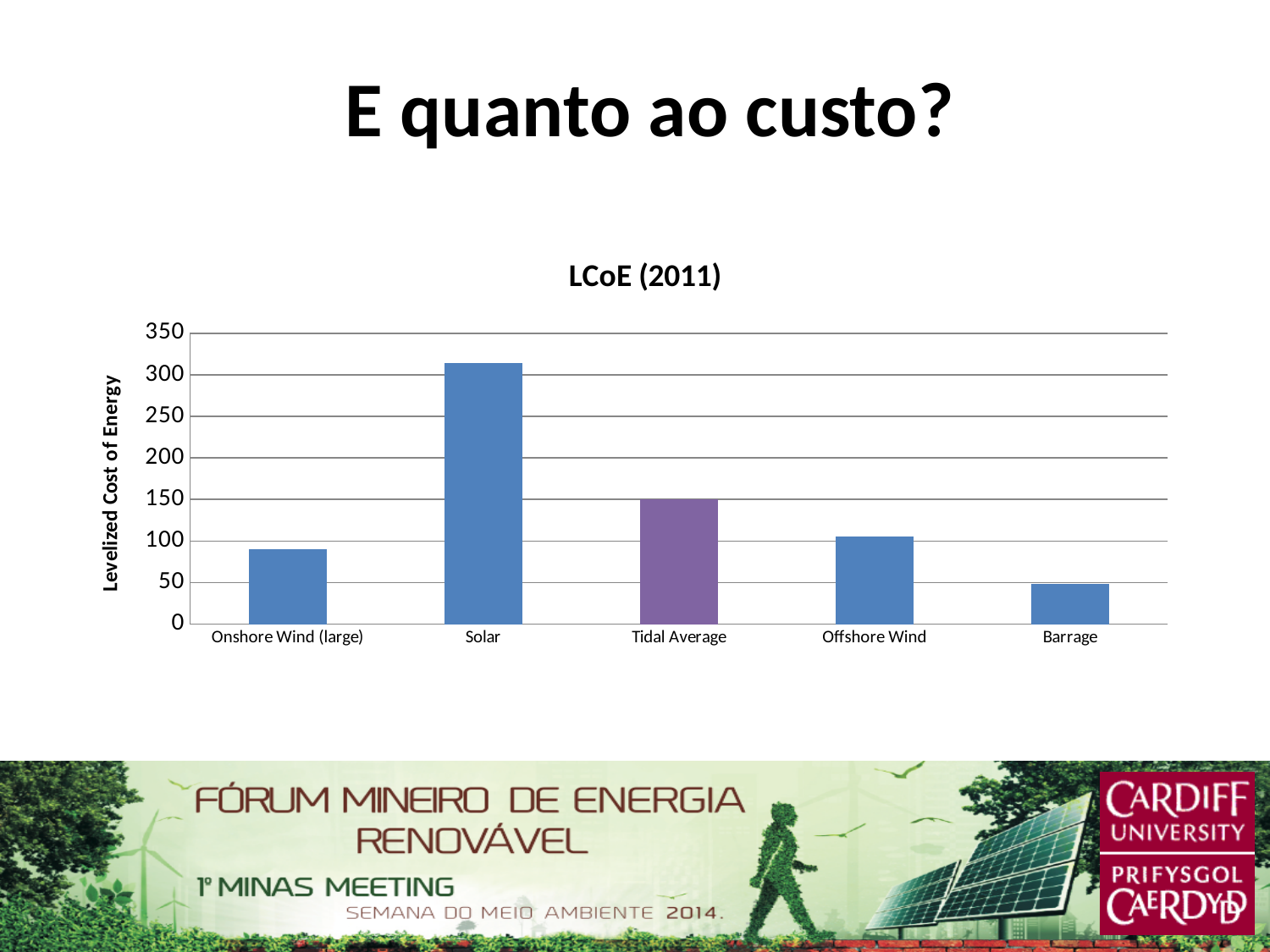
Is the value for Solar greater or less than 300? greater Which category has the lowest value in the chart? Barrage Which category has the highest value in the chart? Solar Is the value for Offshore Wind greater or less than 100? greater How many categories are shown on the x axis of the chart? 5 What is the title of the chart? LCoE (2011) Which is larger, the value for Onshore Wind (large) or the value for Barrage? Onshore Wind (large) What is the label on the vertical axis of the chart? Levelized Cost of Energy Is the value for Onshore Wind (large) greater or less than 100? less What type of chart is shown on the slide? bar chart Which is larger, the value for Tidal Average or the value for Offshore Wind? Tidal Average